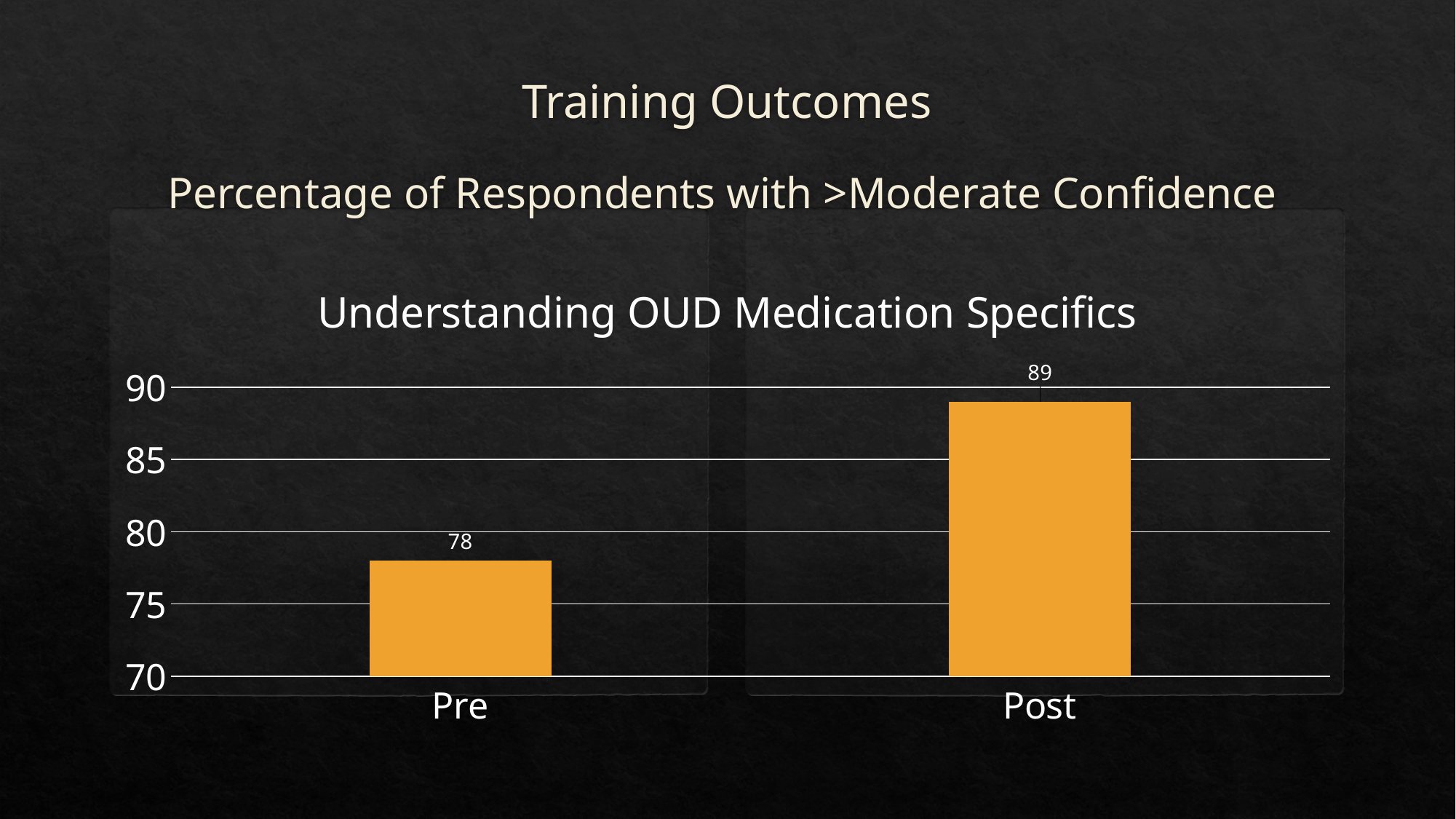
Do the values rise or fall from Pre to Post? rise What kind of chart is shown? bar chart What is the title of the chart? Understanding OUD Medication Specifics Is the value for Post greater or less than 85? greater How many categories are shown on the x axis? 2 What is the value for Pre? 78 Which category has the lowest value? Pre Is the value for Pre greater or less than 80? less Which is larger, the value for Pre or the value for Post? Post Which category has the highest value? Post What is the difference between the Post and Pre values? 11 What is the value for Post? 89